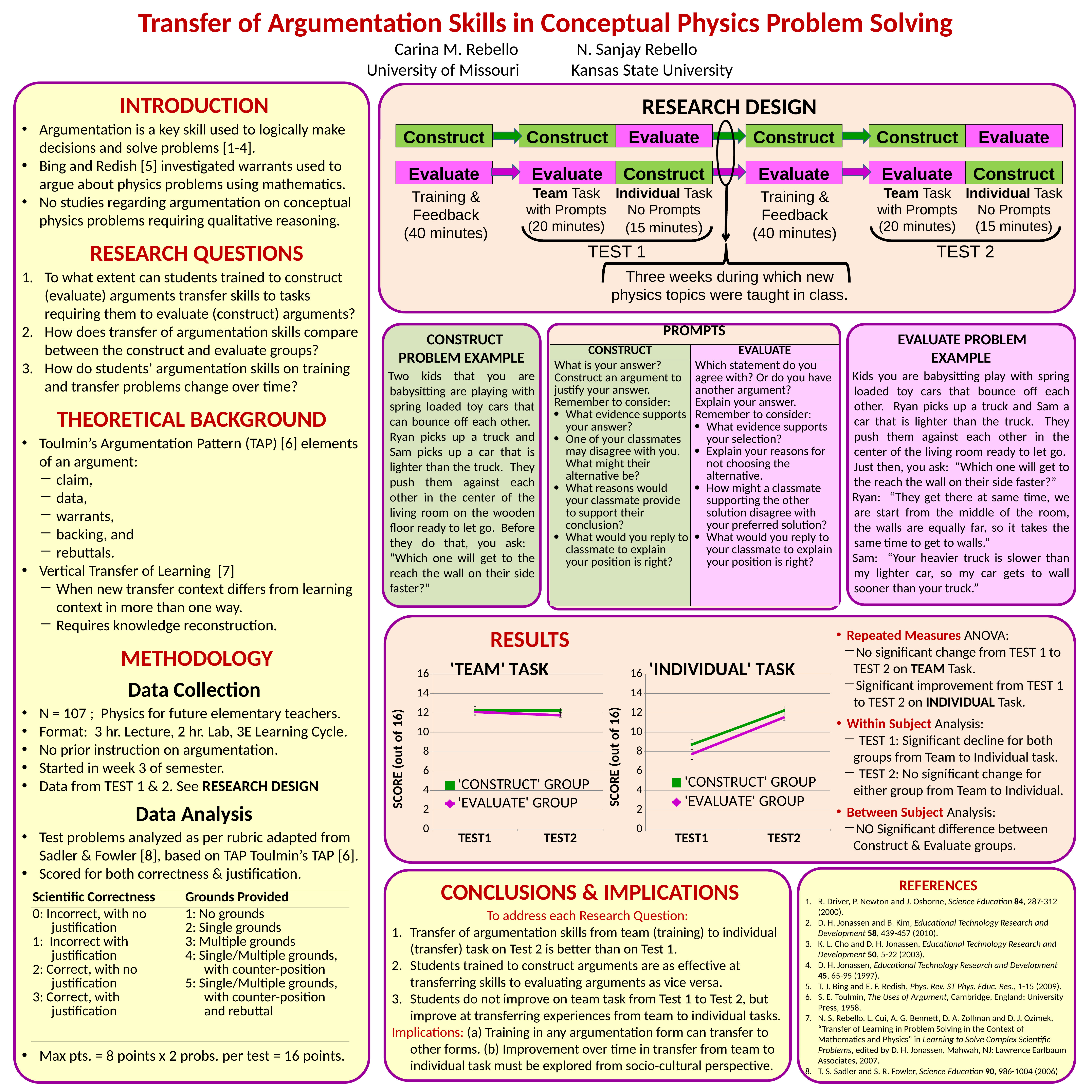
What kind of chart is the 'TEAM' TASK chart? line chart In the 'TEAM' TASK chart, is the 'EVALUATE' GROUP score at TEST2 greater or less than 14? less In the 'INDIVIDUAL' TASK chart, is the 'CONSTRUCT' GROUP score at TEST2 greater or less than 10? greater In the 'INDIVIDUAL' TASK chart, is the 'CONSTRUCT' GROUP score at TEST1 greater or less than 10? less How many series does the legend of the 'INDIVIDUAL' TASK chart list? 2 In the 'INDIVIDUAL' TASK chart, do the scores rise or fall from TEST1 to TEST2? rise What is the y-axis label of the 'TEAM' TASK chart? SCORE (out of 16) How many test points are plotted along the x axis of the 'TEAM' TASK chart? 2 What colour is the 'EVALUATE' GROUP line in the 'INDIVIDUAL' TASK chart? magenta In the 'INDIVIDUAL' TASK chart, which group has the higher score at TEST1, 'CONSTRUCT' GROUP or 'EVALUATE' GROUP? 'CONSTRUCT' GROUP